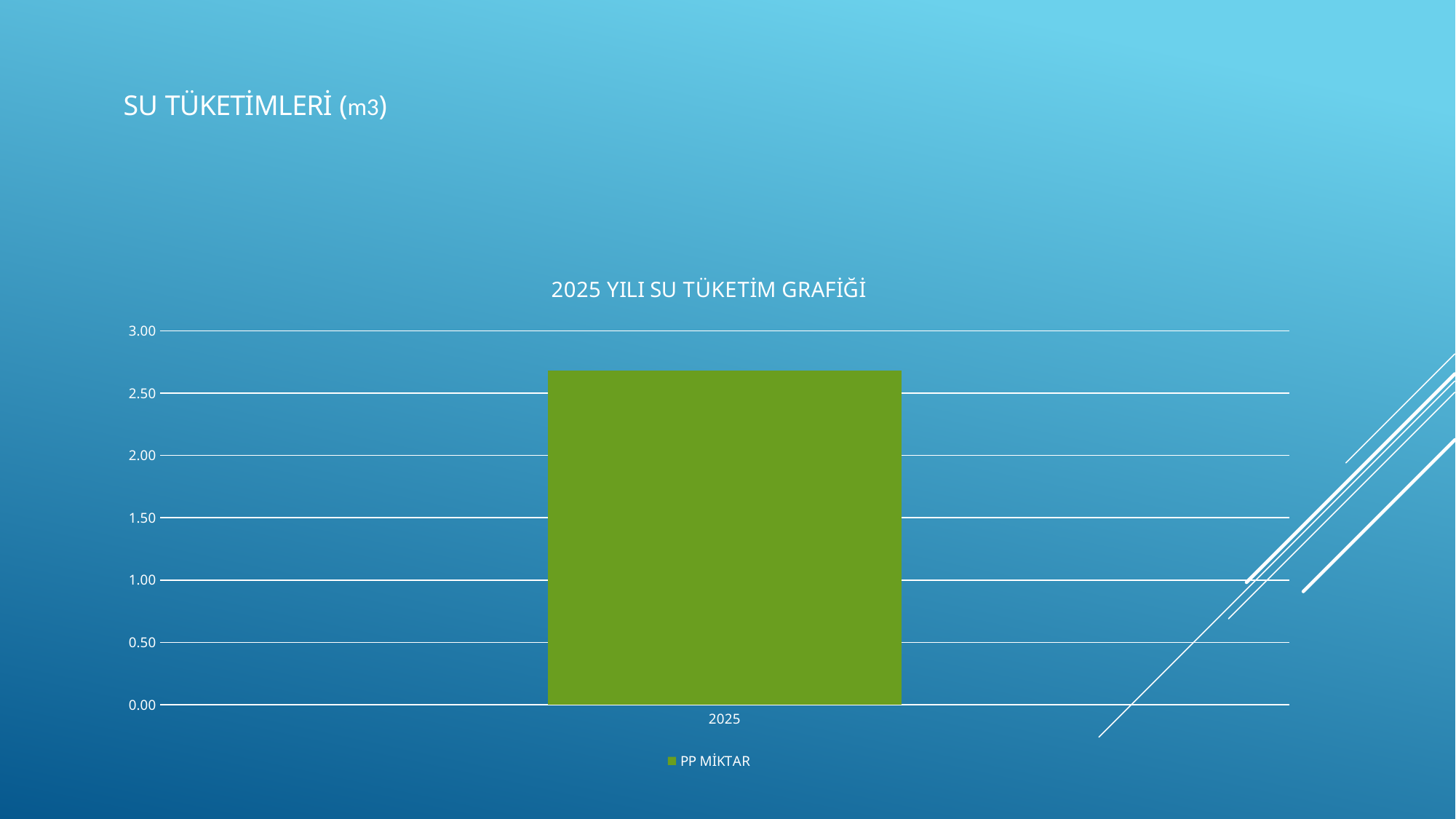
What kind of chart is shown on the slide? bar chart Is the value for 2025 greater or less than 2.50? greater What series name is shown in the chart's legend? PP MİKTAR How many categories are plotted on the x axis of the chart? 1 How many series does the chart's legend list? 1 What is the title of the chart? 2025 YILI SU TÜKETİM GRAFİĞİ Is the value for 2025 greater or less than 3.00? less Is the value for 2025 greater or less than 2.00? greater